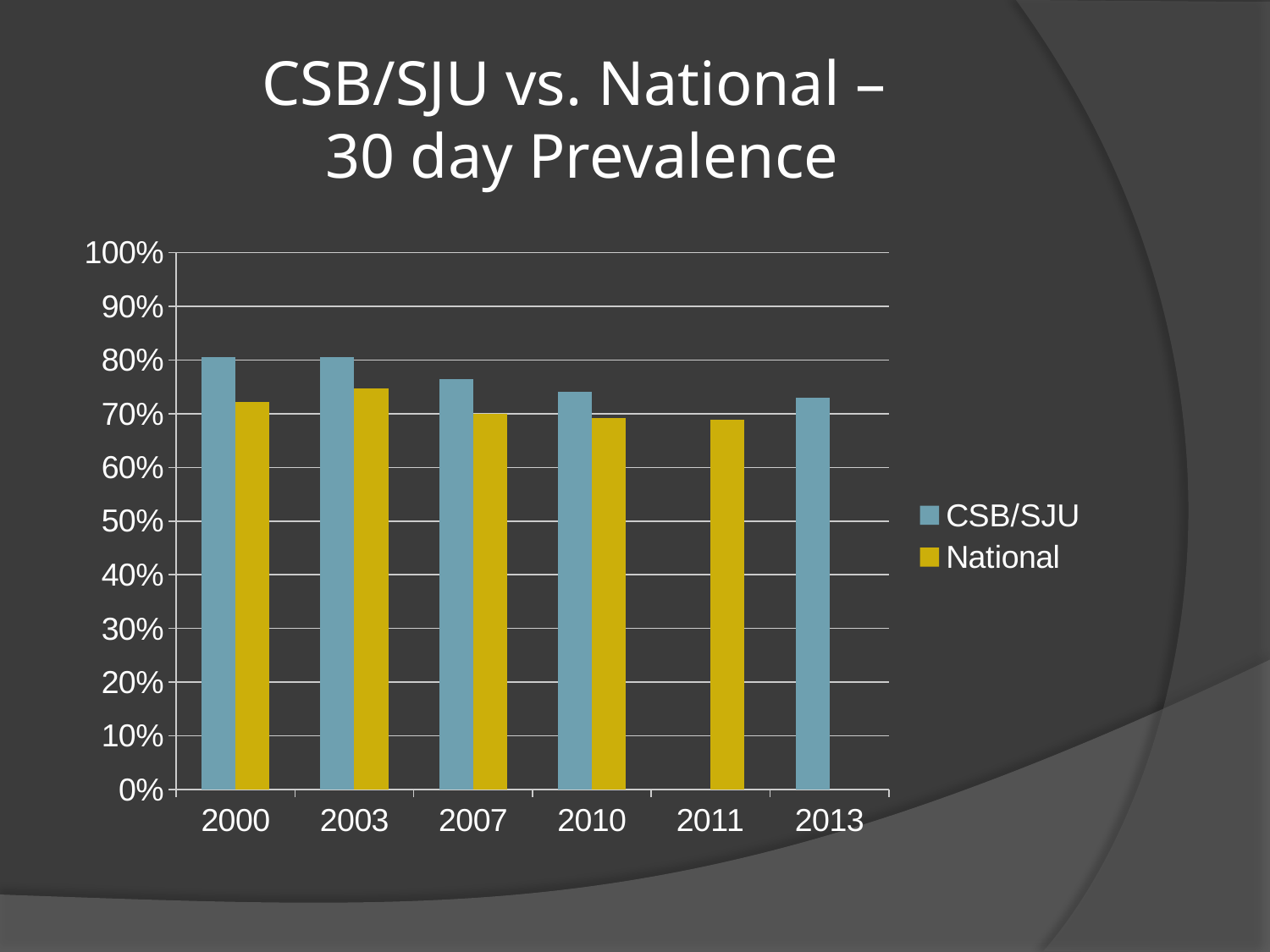
Is the CSB/SJU value for 2013 greater or less than 70%? greater What kind of chart is shown on the slide? Bar chart What is the title of the chart? CSB/SJU vs. National – 30 day Prevalence Do the CSB/SJU values generally rise or fall from 2000 to 2013? Fall Which year has the highest National value? 2003 How many series does the legend list? 2 In 2007, which is larger, the CSB/SJU value or the National value? CSB/SJU How many years are shown on the x axis? 6 Is the National value for 2003 greater or less than 80%? less Which series is shown in yellow? National